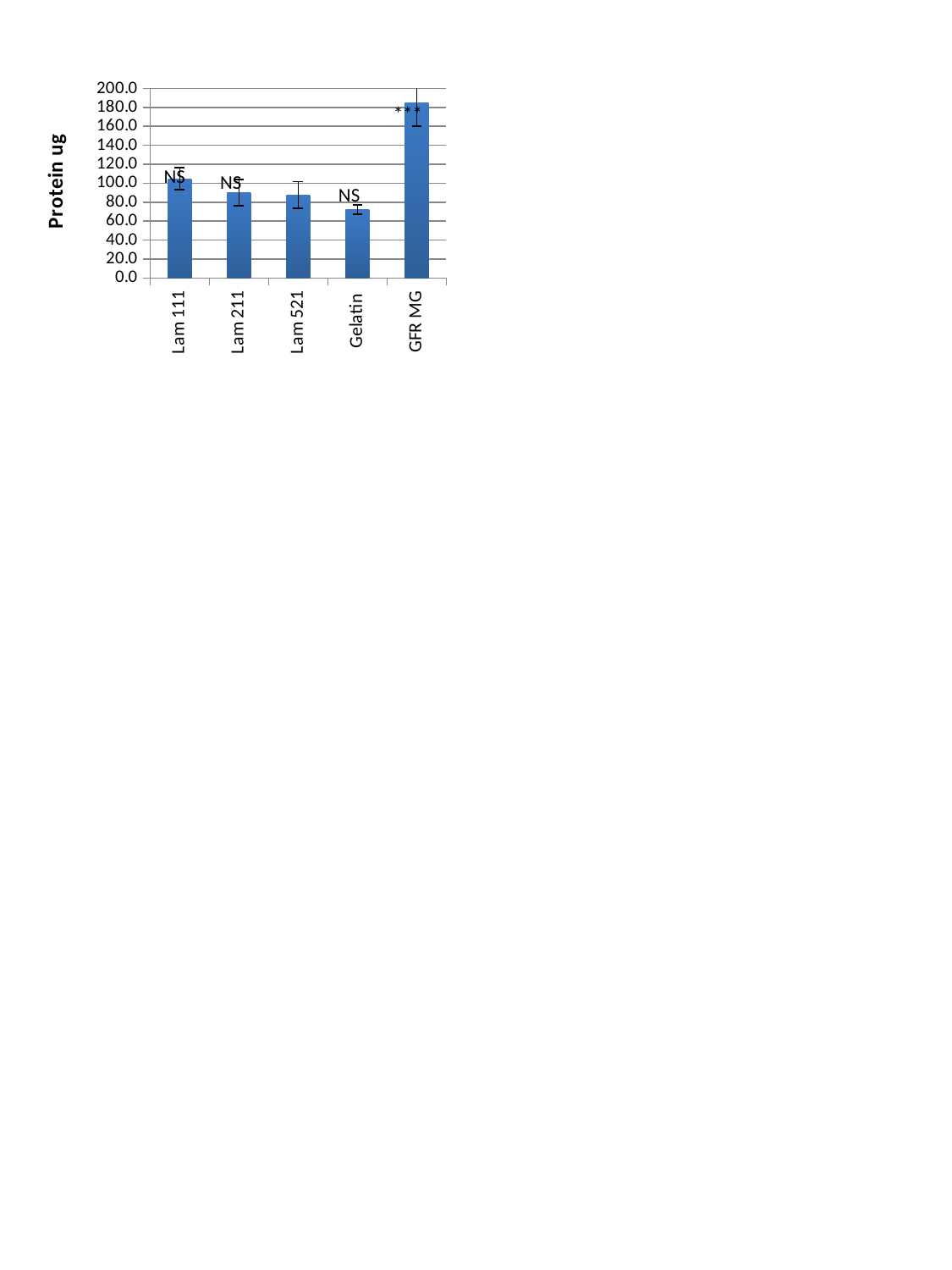
Which category has the highest protein value? GFR MG Is the value for Lam 211 greater or less than 100? less Which category has the lowest protein value? Gelatin Is the value for Gelatin greater or less than 80? less What kind of chart is shown on the slide? bar chart Is the value for GFR MG greater or less than 160? greater Which is larger, the value for Lam 111 or the value for Gelatin? Lam 111 Which is larger, the value for GFR MG or the value for Lam 111? GFR MG What is the label on the y axis? Protein ug What annotation is printed above the GFR MG bar? *** How many categories are plotted on the x axis? 5